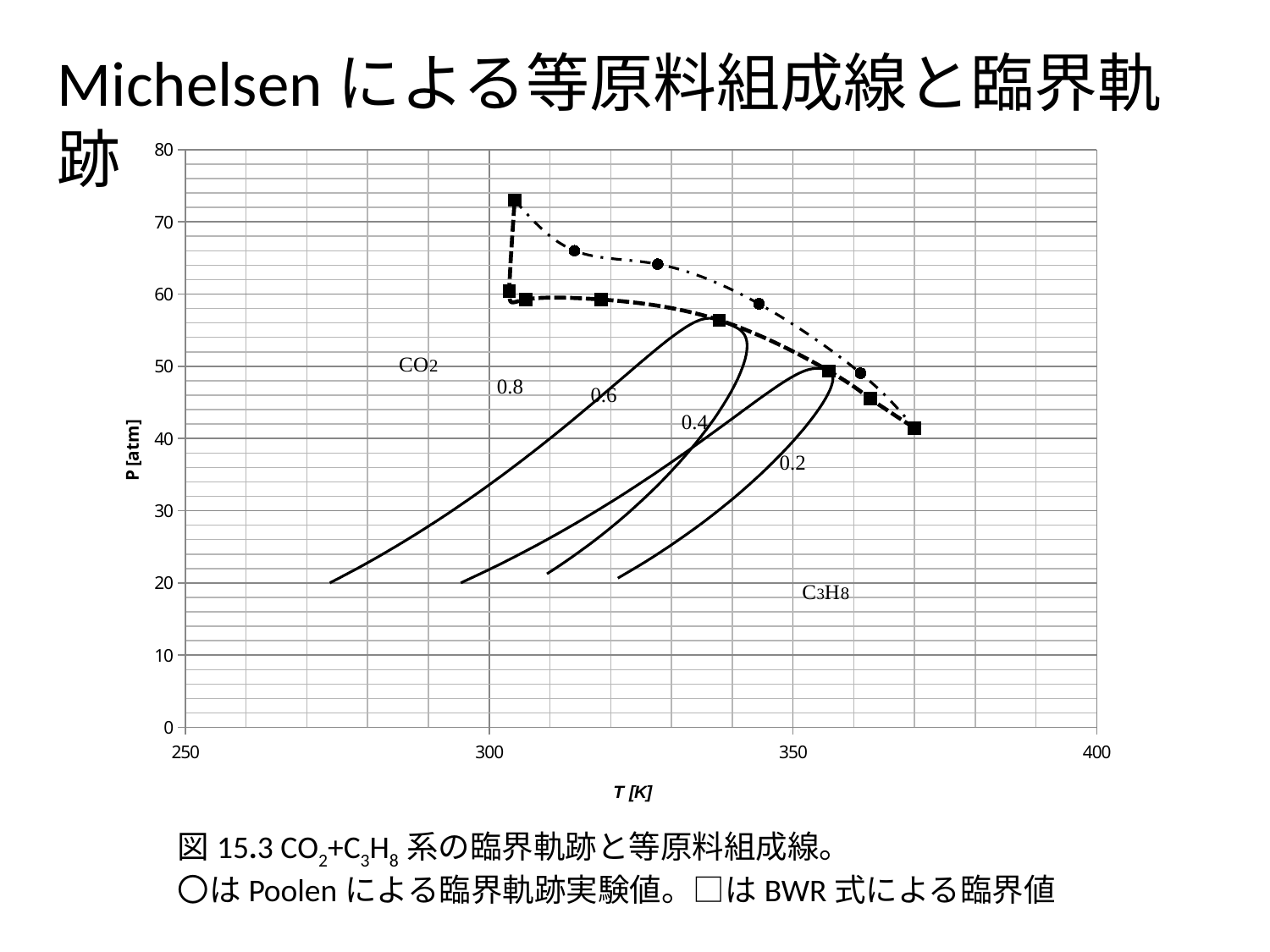
Is the peak pressure of the 0.8 composition curve greater or less than 50 atm? greater Is the pressure of the highest square marker (near 304 K) greater or less than 70 atm? greater Along the dashed critical locus from about 310 K to 370 K, does the pressure rise or fall as temperature increases? fall What is the label of the horizontal axis of the chart? T [K] What is the label of the vertical axis of the chart? P [atm] What kind of chart is shown on the slide? line chart Is the pressure of the leftmost circle marker (near 314 K) greater or less than 60 atm? greater Which has the higher pressure: the square marker near 304 K at the top of the dashed line, or the rightmost square marker near 371 K? the square marker near 304 K How many circle markers (Poolen experimental values) are plotted on the chart? 4 What is the maximum value shown on the vertical (P) axis of the chart? 80 How many composition values (0.2, 0.4, ...) are labelled on the solid curves in the chart? 4